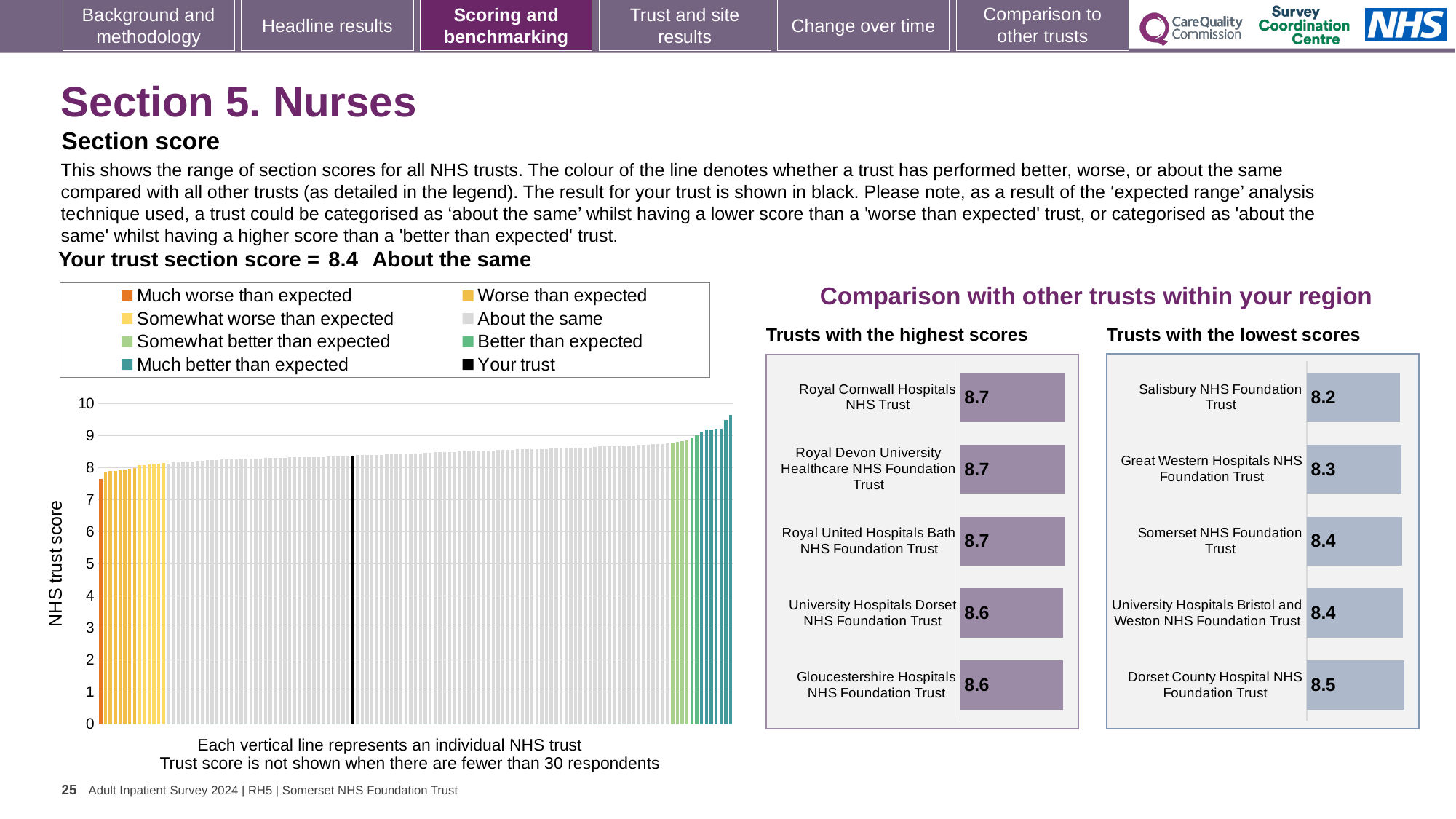
In the 'Trusts with the highest scores' chart, what is the score for Gloucestershire Hospitals NHS Foundation Trust? 8.6 How many entries does the legend of the large chart on the left list? 8 In the 'Trusts with the lowest scores' chart, which trust has the highest score? Dorset County Hospital NHS Foundation Trust In the 'Trusts with the highest scores' chart, which has the larger score: Royal Cornwall Hospitals NHS Trust or University Hospitals Dorset NHS Foundation Trust? Royal Cornwall Hospitals NHS Trust How many trusts are listed in the 'Trusts with the highest scores' chart? 5 What kind of chart is the large chart on the left showing NHS trust scores? Bar chart In the 'Trusts with the highest scores' chart, what is the score for Royal Cornwall Hospitals NHS Trust? 8.7 In the 'Trusts with the lowest scores' chart, which has the larger score: Great Western Hospitals NHS Foundation Trust or Somerset NHS Foundation Trust? Somerset NHS Foundation Trust In the 'Trusts with the lowest scores' chart, what is the score for Salisbury NHS Foundation Trust? 8.2 In the 'Trusts with the lowest scores' chart, which trust has the lowest score? Salisbury NHS Foundation Trust In the 'Trusts with the lowest scores' chart, what is the difference between the scores of Dorset County Hospital NHS Foundation Trust and Salisbury NHS Foundation Trust? 0.3 In the large chart on the left showing NHS trust scores, is the value for the black 'Your trust' bar greater or less than 8? greater